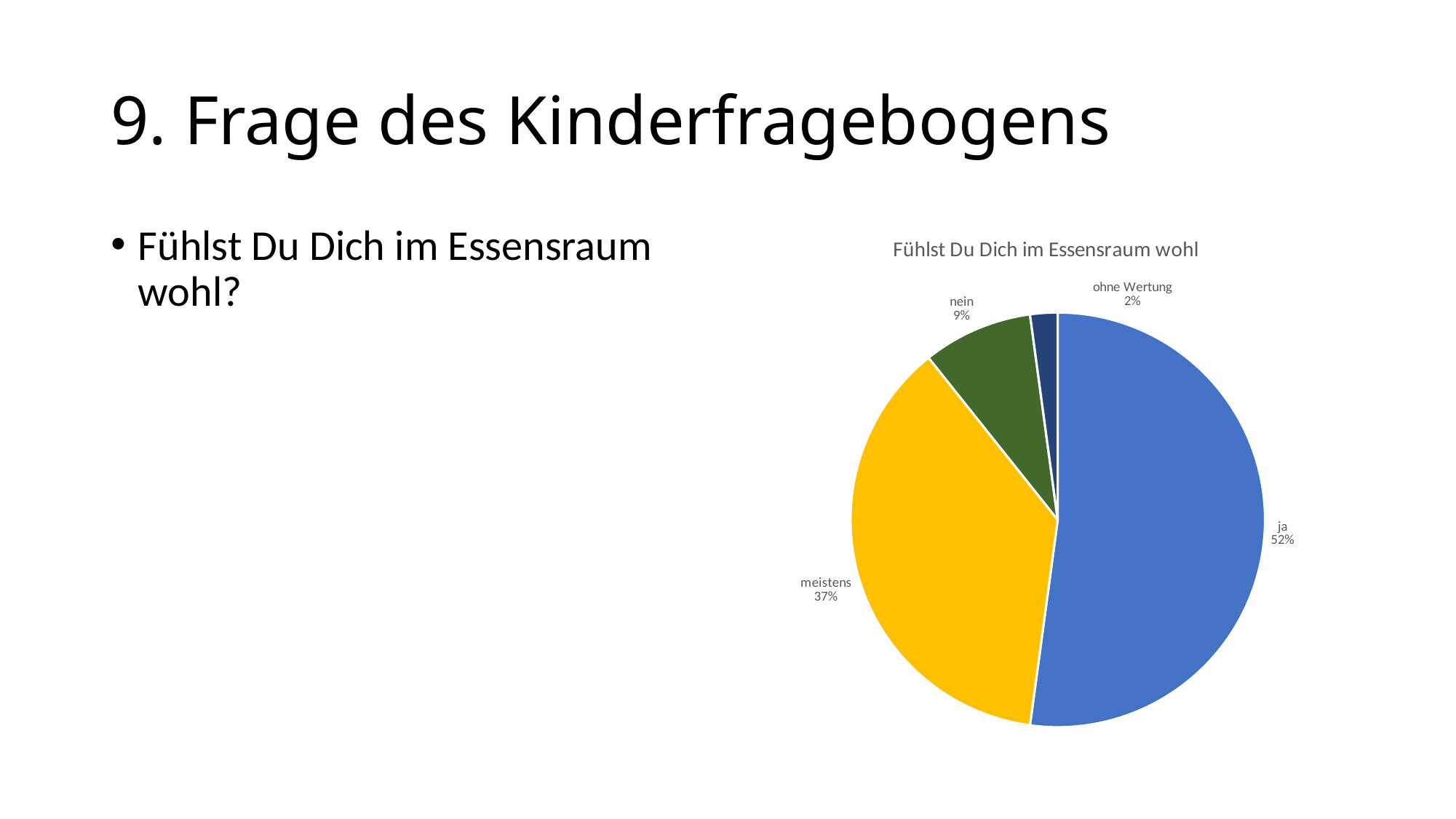
Which category has the largest slice of the pie? ja How many slices does the pie chart have? 4 Which category has the smallest slice of the pie? ohne Wertung What share of the pie does "nein" have? 9% What share of the pie does "ohne Wertung" have? 2% What share of the pie does "meistens" have? 37% Which is larger, the share for "nein" or the share for "ohne Wertung"? nein What colour is the "meistens" slice? yellow What is the difference in percentage points between "ja" and "meistens"? 15 What kind of chart is shown on the slide? pie chart What is the title of the chart? Fühlst Du Dich im Essensraum wohl